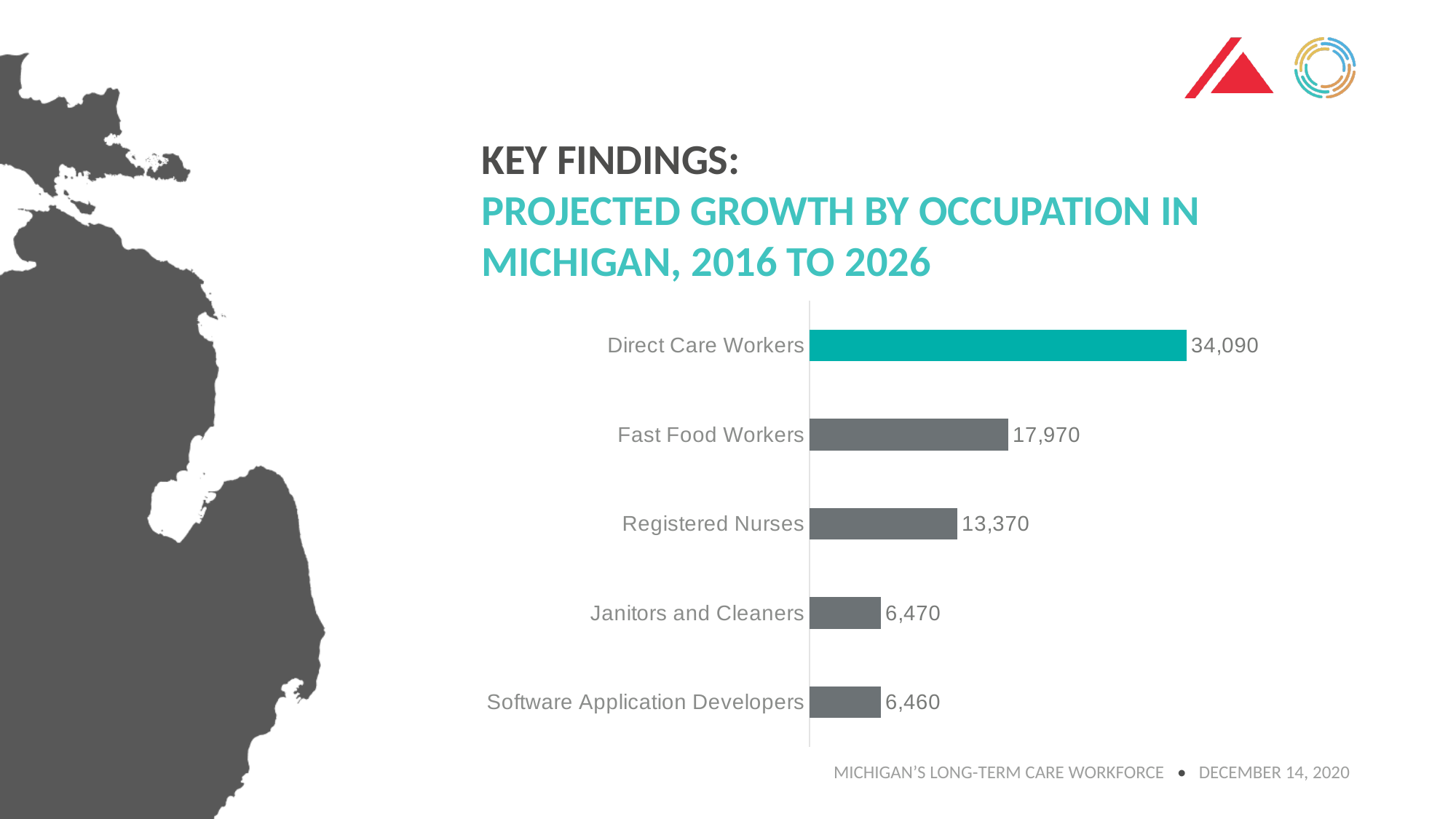
What is the projected growth for Janitors and Cleaners? 6,470 What is the projected growth for Registered Nurses? 13,370 What is the difference in projected growth between Direct Care Workers and Fast Food Workers? 16,120 Which has a larger projected growth, Registered Nurses or Fast Food Workers? Fast Food Workers What is the projected growth for Software Application Developers? 6,460 What is the difference in projected growth between Fast Food Workers and Registered Nurses? 4,600 Which occupation has the highest projected growth? Direct Care Workers How many occupations are shown in the chart? 5 Which bar is shown in a different colour (teal) from the others? Direct Care Workers What is the projected growth for Fast Food Workers? 17,970 What is the projected growth for Direct Care Workers? 34,090 What type of chart is shown on the slide? Bar chart